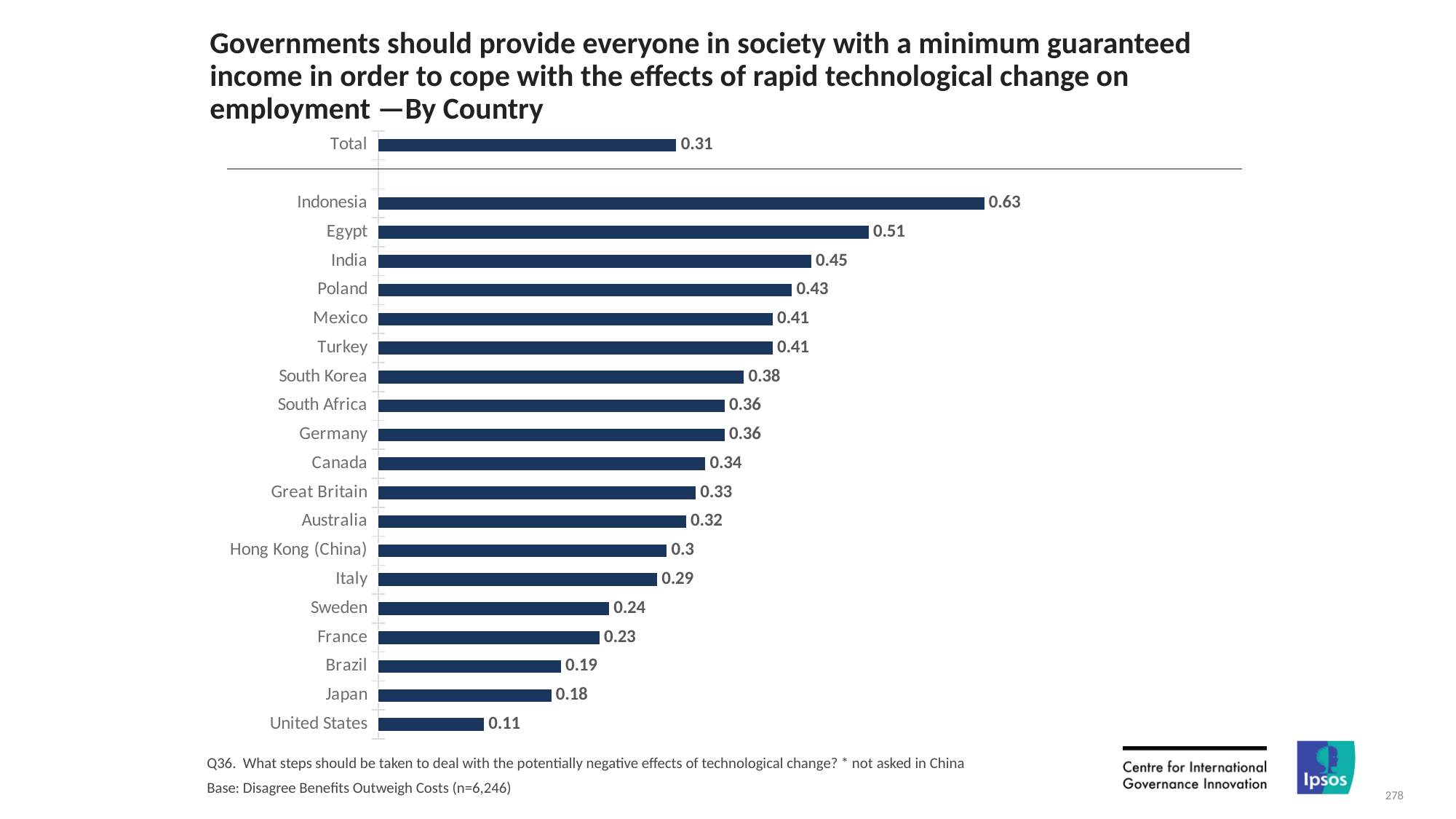
Which is larger, the value for Poland or the value for South Korea? Poland What is the difference between the values for Canada and the United States? 0.23 Which country has the lowest value? United States How many countries are listed on the chart, excluding the Total bar? 19 What is the value for Indonesia? 0.63 What kind of chart is shown on the slide? Bar chart What is the base sample size (n) stated at the bottom of the slide? 6,246 What is the difference between the values for Indonesia and Egypt? 0.12 Which is larger, the value for France or the value for Italy? Italy What is the value for Japan? 0.18 Which country has the highest value? Indonesia What is the value for the Total bar? 0.31